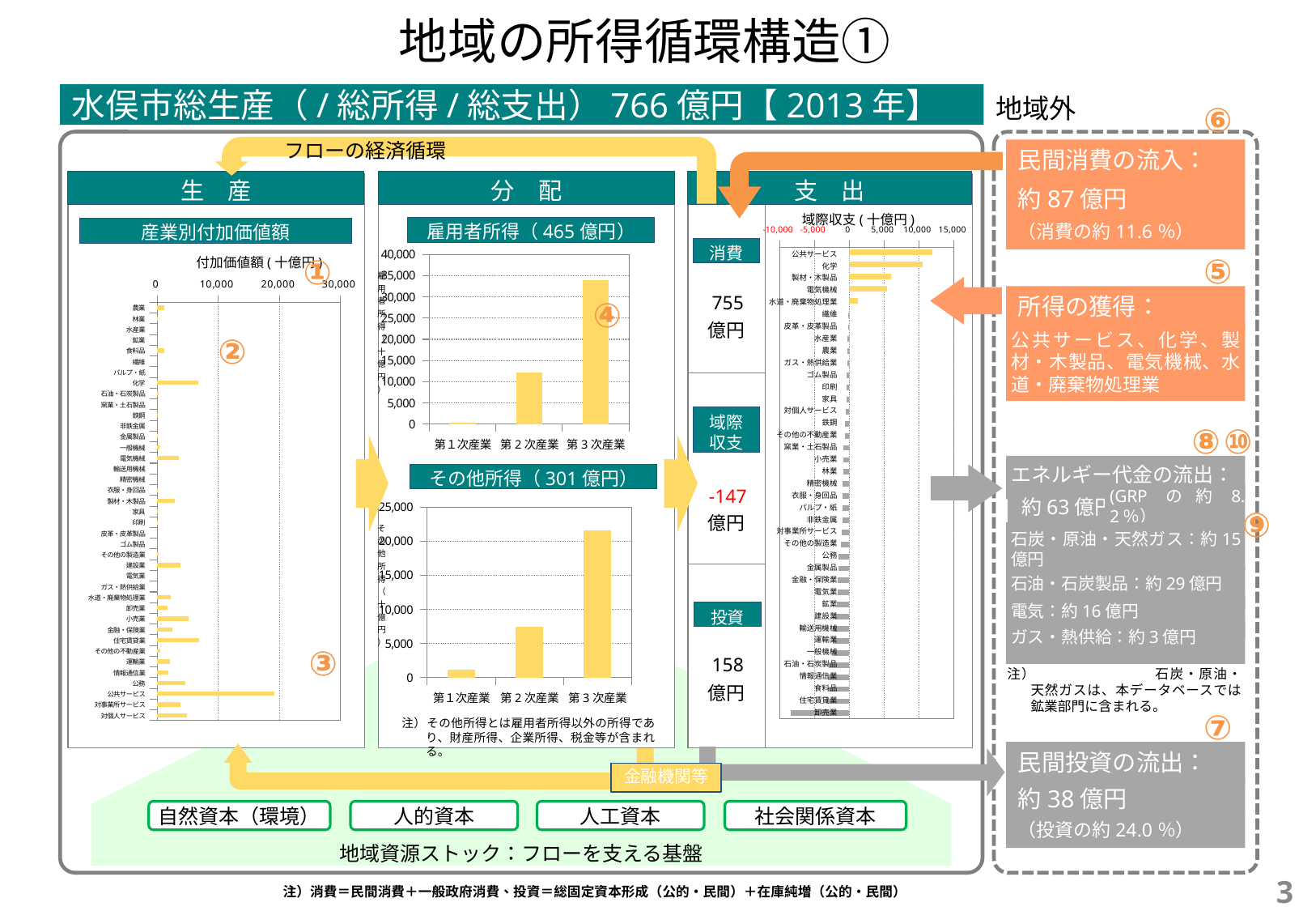
In the 雇用者所得（465億円） chart, is the value for 第3次産業 greater or less than 30,000? greater In the 雇用者所得（465億円） chart, which category has the highest value? 第3次産業 In the その他所得（301億円） chart, which is larger, the value for 第1次産業 or 第2次産業? 第2次産業 In the その他所得（301億円） chart, which category has the highest value? 第3次産業 What kind of chart is the 雇用者所得（465億円） chart? bar chart In the 雇用者所得（465億円） chart, which category has the lowest value? 第1次産業 How many categories are shown on the x axis of the 雇用者所得（465億円） chart? 3 In the その他所得（301億円） chart, is the value for 第3次産業 greater or less than 20,000? greater In the 産業別付加価値額 chart, which industry has the highest value? 公共サービス In the 域際収支 chart, is the value for 公共サービス greater or less than 10,000? greater